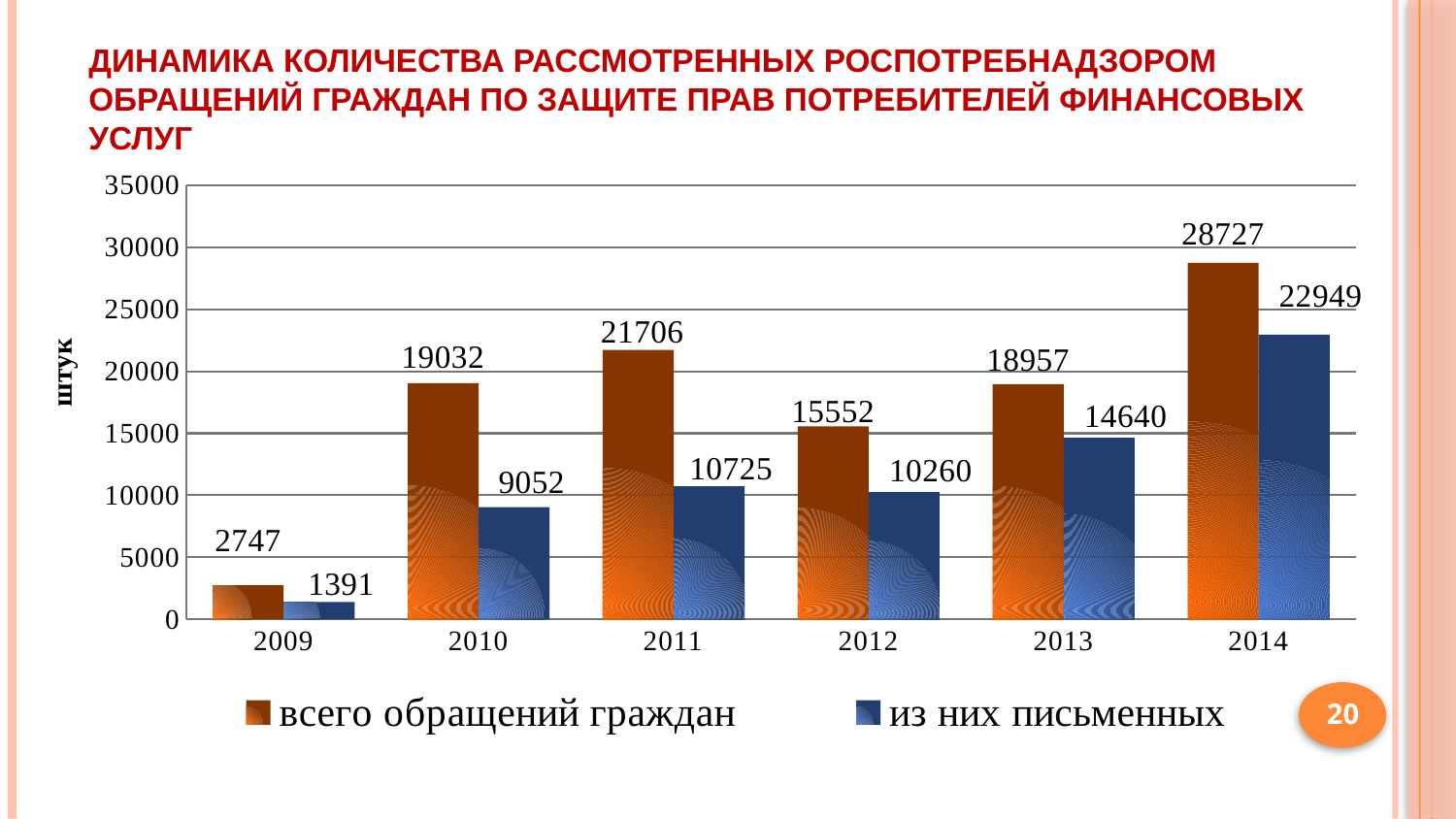
What is the label on the vertical axis? штук Which year has the lowest value for "из них письменных"? 2009 Which year has the highest value for "всего обращений граждан"? 2014 Is the value of "из них письменных" for 2014 greater or less than 20000? greater How many series does the legend list? 2 Which is larger: "всего обращений граждан" in 2011 or in 2012? 2011 What is the difference between "всего обращений граждан" and "из них письменных" in 2013? 4317 What kind of chart is shown on the slide? bar chart What is the value of "всего обращений граждан" for 2014? 28727 How many years are shown on the x axis? 6 What is the value of "из них письменных" for 2009? 1391 What is the value of "из них письменных" for 2011? 10725